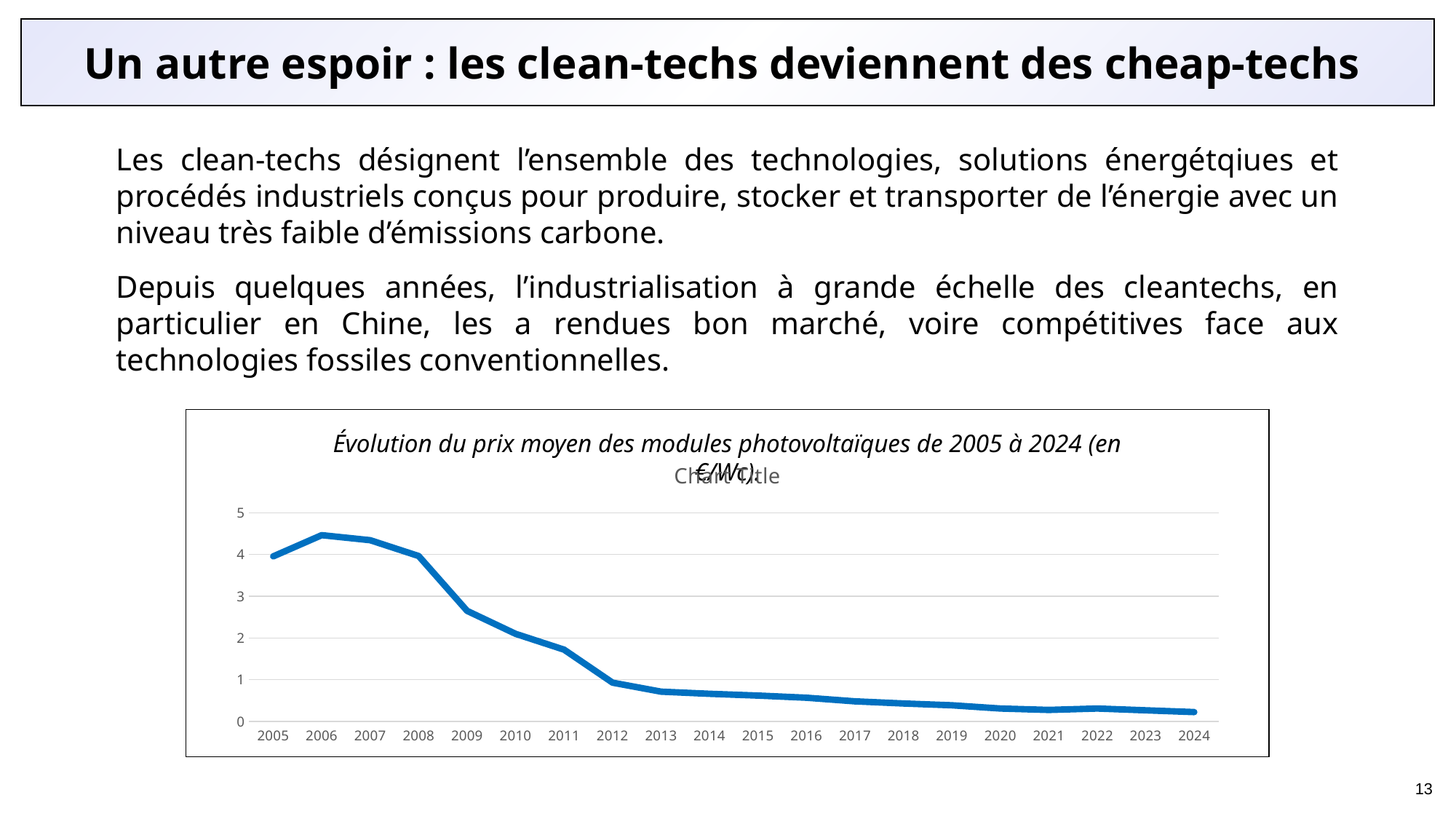
Is the value for 2005 greater or less than 3? greater Is the value for 2013 greater or less than 1? less Which year has the larger value, 2009 or 2013? 2009 Overall, do the values rise or fall from 2005 to 2024? fall Which year has the larger value, 2005 or 2024? 2005 What is the highest tick value shown on the y axis of the chart? 5 What kind of chart is shown on the slide? line chart How many years (data points) are plotted on the x axis of the chart? 20 Is the value for 2011 greater or less than 2? less In which year is the plotted value highest? 2006